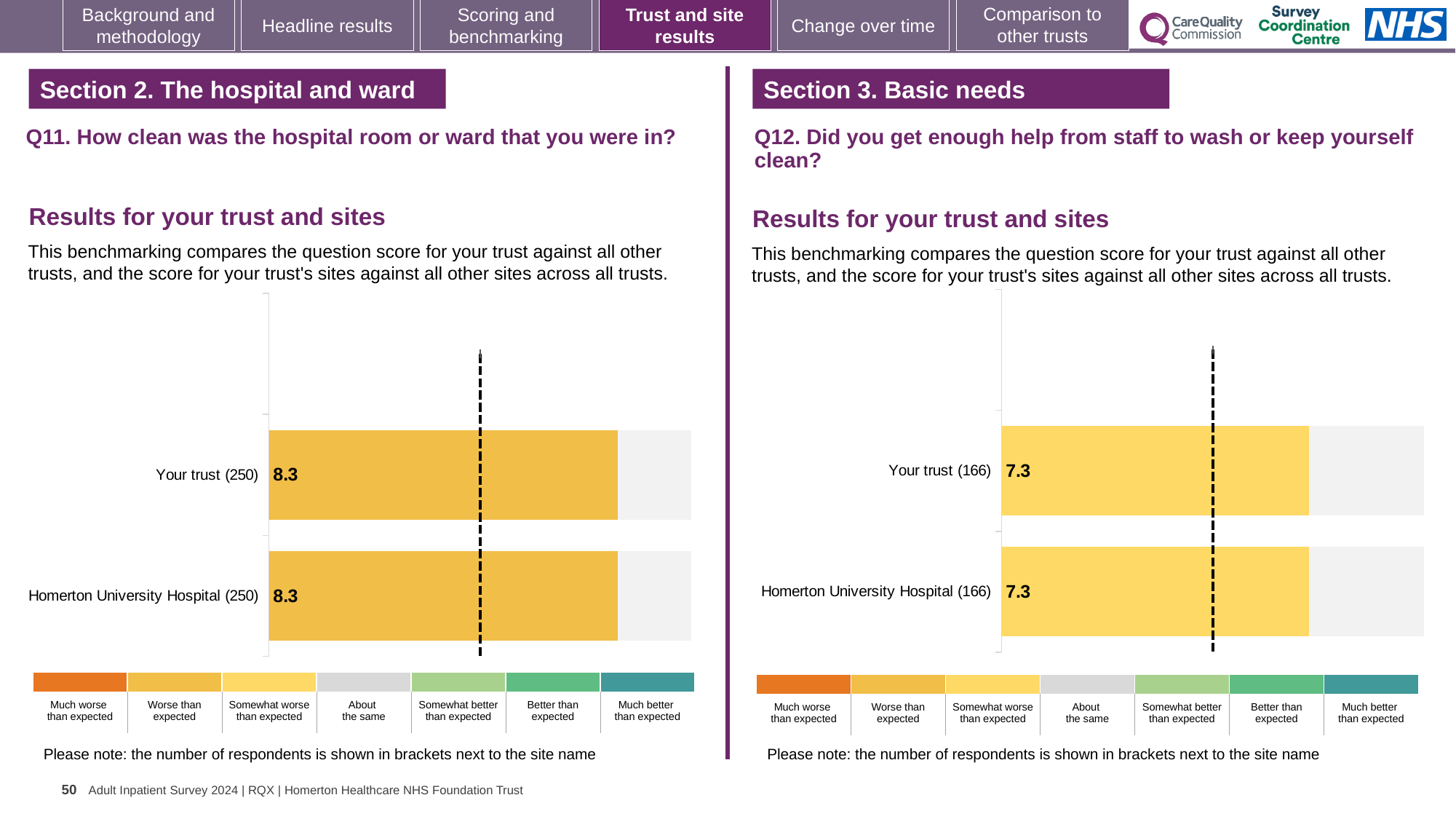
In the Q12 chart on the right, what is the score for Your trust? 7.3 Is the score for Your trust in the Q11 chart on the left larger or smaller than the score for Your trust in the Q12 chart on the right? Larger What kind of chart is used for the Q11 results on the left? Bar chart How many bars are plotted in the Q12 chart on the right? 2 In the Q11 chart on the left, what is the score for Your trust? 8.3 In the Q12 chart on the right, what is the score for Homerton University Hospital? 7.3 In the Q12 chart on the right, how many respondents are shown in brackets for Homerton University Hospital? 166 In the Q11 chart on the left, what is the score for Homerton University Hospital? 8.3 In the Q11 chart on the left, how many respondents are shown in brackets for Your trust? 250 In the Q12 chart on the right, what is the difference between the score for Your trust and the score for Homerton University Hospital? 0.0 How many bars are plotted in the Q11 chart on the left? 2 In the Q11 chart on the left, what is the difference between the score for Your trust and the score for Homerton University Hospital? 0.0